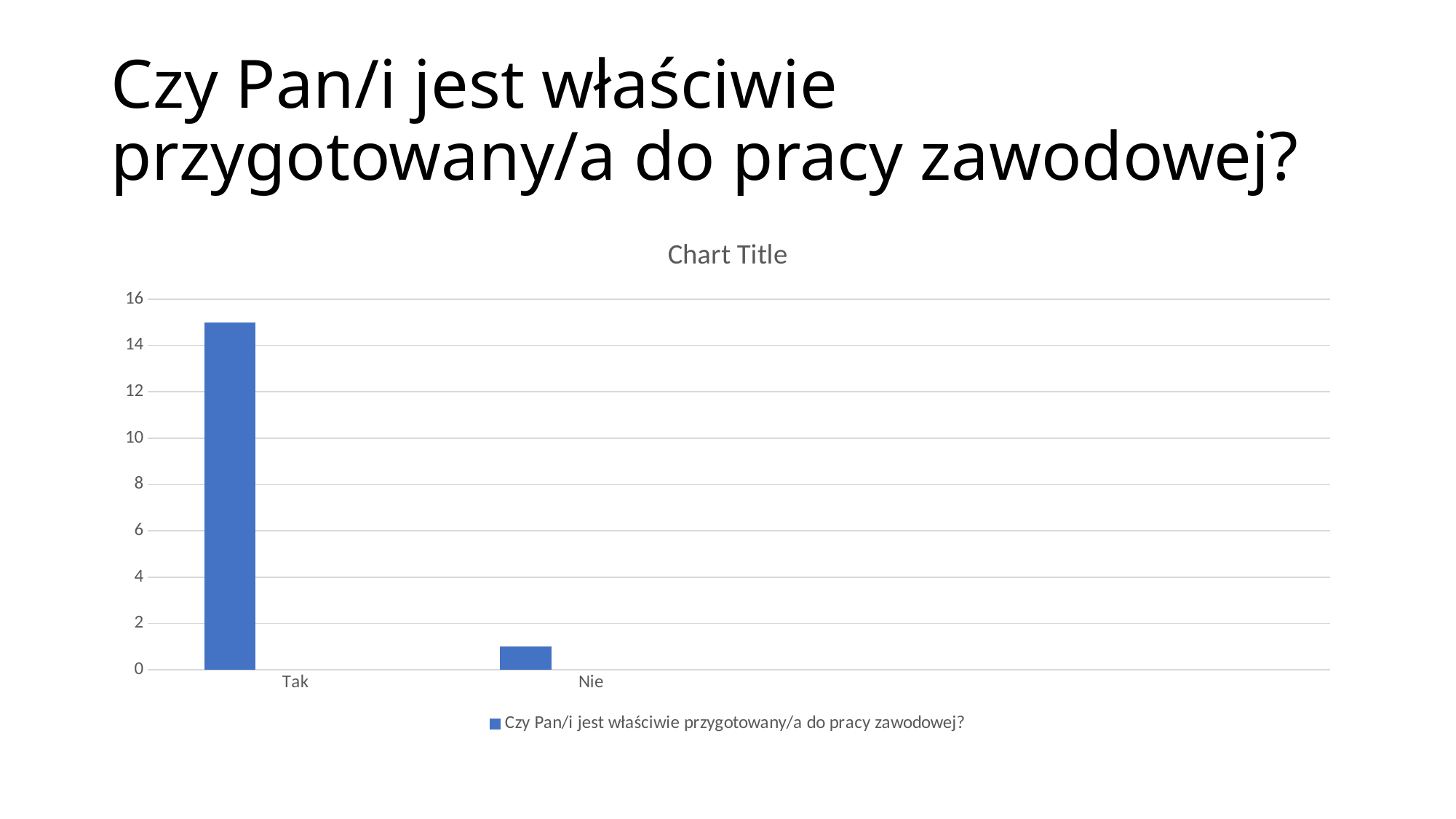
How many categories are shown on the x axis of the chart? 2 Is the value for Tak greater or less than 14? greater What kind of chart is shown on the slide? bar chart Is the value for Tak greater or less than 16? less How many series does the chart legend list? 1 Do the bar values rise or fall from Tak to Nie along the x axis? fall Which category has the lowest bar in the chart? Nie Which bar is taller, Tak or Nie? Tak Is the value for Nie greater or less than 2? less Which category has the highest bar in the chart? Tak What is the series name shown in the chart legend? Czy Pan/i jest właściwie przygotowany/a do pracy zawodowej? What is the title shown above the chart? Chart Title